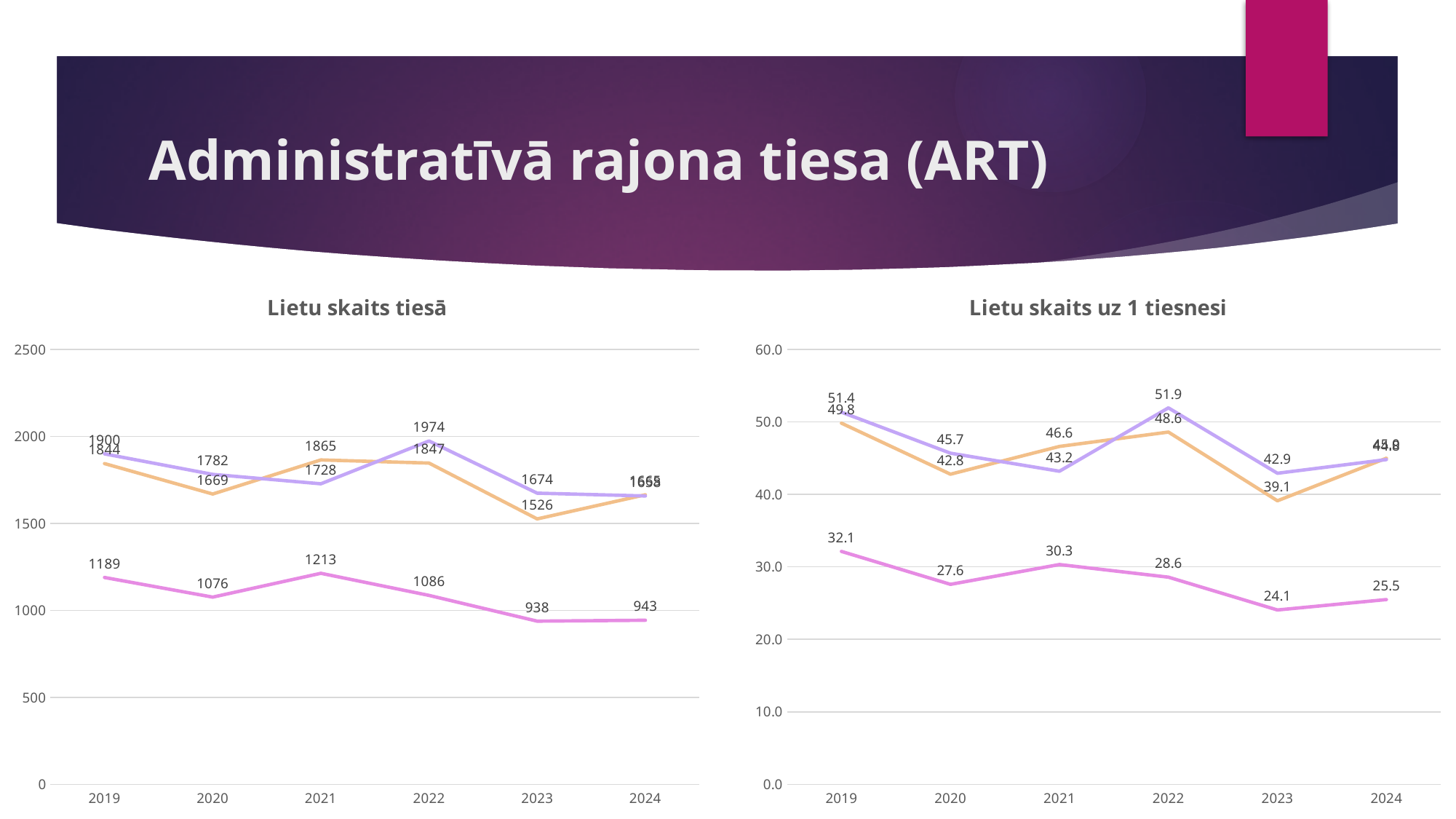
What kind of chart is the left chart titled "Lietu skaits tiesā"? line chart In the right chart "Lietu skaits uz 1 tiesnesi", is the pink line's value in 2024 greater or less than 30.0? less In the right chart "Lietu skaits uz 1 tiesnesi", what is the value of the purple line in 2022? 51.9 In the left chart "Lietu skaits tiesā", in which year does the pink line reach its highest value? 2021 In the right chart "Lietu skaits uz 1 tiesnesi", what is the value of the pink line in 2019? 32.1 In the left chart "Lietu skaits tiesā", what is the difference between the pink line's 2019 value and its 2023 value? 251 How many years are shown on the x axis of the left chart "Lietu skaits tiesā"? 6 In the left chart "Lietu skaits tiesā", in which year does the pink line reach its lowest value? 2023 In the left chart "Lietu skaits tiesā", what is the value of the pink line in 2021? 1213 In the right chart "Lietu skaits uz 1 tiesnesi", what is the difference between the purple line's 2022 value and its 2023 value? 9.0 In the right chart "Lietu skaits uz 1 tiesnesi", what is the value of the orange line in 2023? 39.1 In the right chart "Lietu skaits uz 1 tiesnesi", which line has the higher value in 2020, the purple line or the orange line? purple line